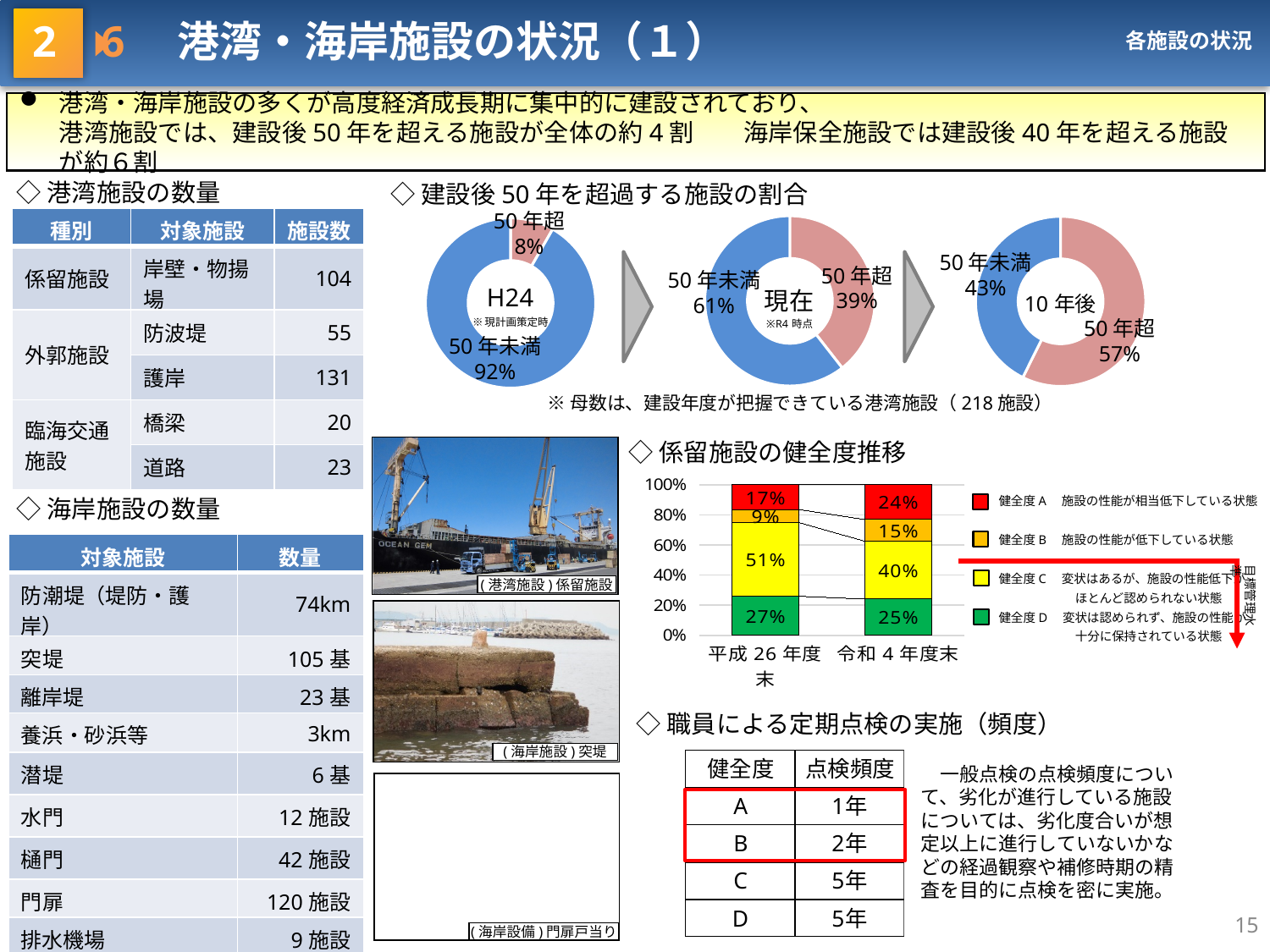
What kind of chart is the 係留施設の健全度推移 chart? stacked bar chart In the 係留施設の健全度推移 chart, is 健全度D larger in 平成26年度末 or 令和4年度末? 平成26年度末 In the 建設後50年を超過する施設の割合 donut charts, what percentage is 50年未満 in the 10年後 chart? 43% In the 係留施設の健全度推移 chart, what is the value for 健全度A in 平成26年度末? 17% In the 建設後50年を超過する施設の割合 donut charts, what percentage is 50年超 in the H24 chart? 8% In the 建設後50年を超過する施設の割合 donut charts, what percentage of facilities is 50年超 in the 現在 chart? 39% In the 建設後50年を超過する施設の割合 donut charts, does the 50年超 share rise or fall from H24 to 現在 to 10年後? rise How many series does the legend of the 係留施設の健全度推移 chart list? 4 In the 係留施設の健全度推移 chart, what is the value for 健全度C in 令和4年度末? 40% In the 建設後50年を超過する施設の割合 donut charts, what is the difference in the 50年超 share between the 10年後 chart and the 現在 chart? 18 percentage points In the 係留施設の健全度推移 chart, which 健全度 has the largest share in the 令和4年度末 bar? 健全度C In the 係留施設の健全度推移 chart, what is the difference in 健全度B between 令和4年度末 and 平成26年度末? 6 percentage points